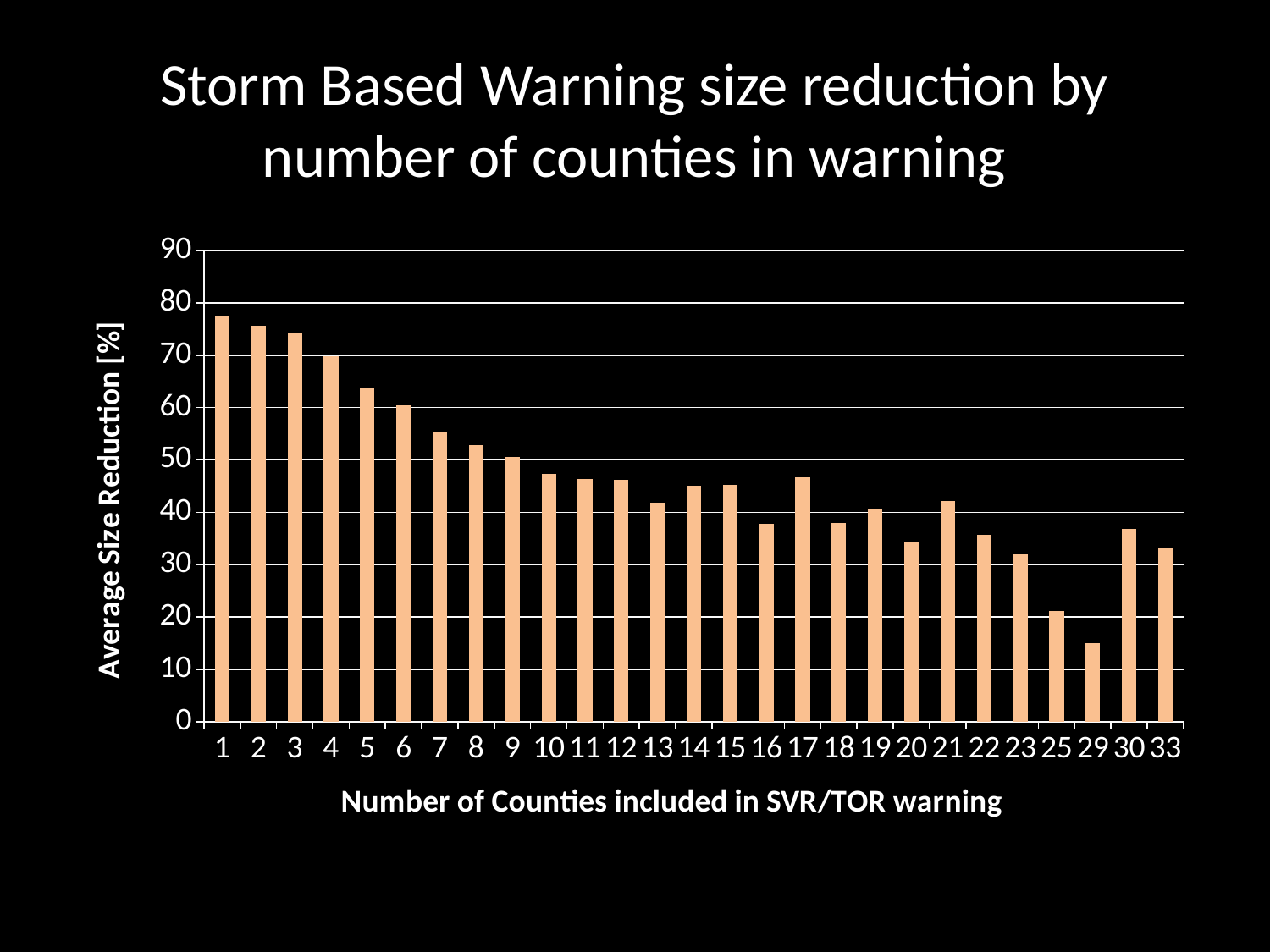
Which number of counties has the lowest average size reduction? 29 Which has a larger average size reduction, 16 counties or 17 counties? 17 counties Is the value for 29 counties greater or less than 20? less How many bars (categories) are plotted on the chart? 27 Is the value for 1 county greater or less than 70? greater Is the value for 16 counties greater or less than 40? less Which has a larger average size reduction, 3 counties or 6 counties? 3 counties What kind of chart is shown on the slide? bar chart Do the values generally rise or fall as the number of counties increases along the x axis? fall What is the label of the vertical axis? Average Size Reduction [%] Which number of counties has the highest average size reduction? 1